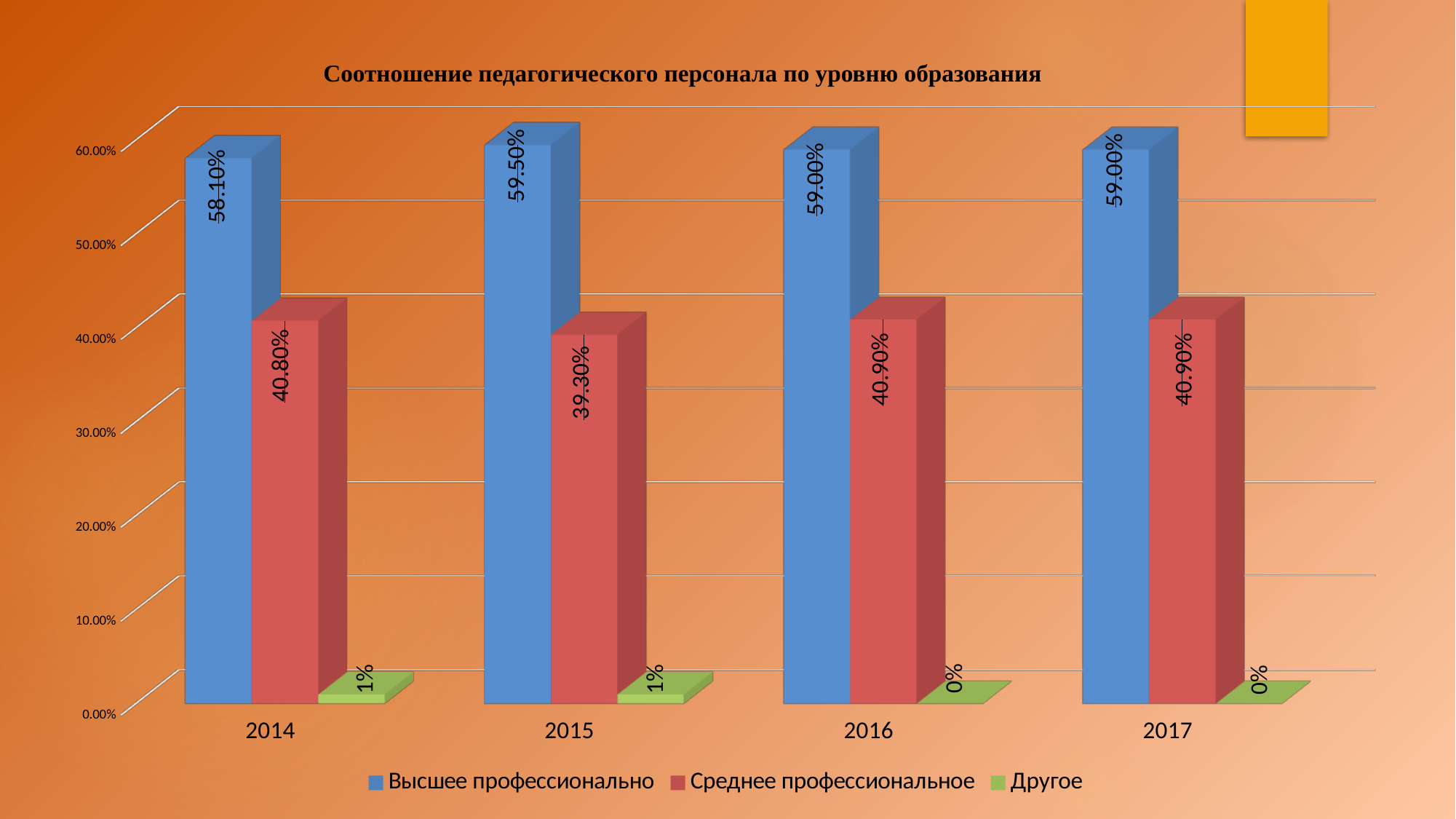
What is the value for Среднее профессиональное in 2017? 40.90% In which year is the value for Среднее профессиональное the lowest? 2015 How many years are shown on the x axis? 4 In which year is the value for Высшее профессионально the highest? 2015 What is the value for Высшее профессионально in 2014? 58.10% What is the difference between Высшее профессионально and Среднее профессиональное in 2015? 20.20% What is the value for Другое in 2016? 0% What is the value for Среднее профессиональное in 2015? 39.30% What is the title of the chart? Соотношение педагогического персонала по уровню образования What kind of chart is shown on the slide? Bar chart Which is larger in 2014: Высшее профессионально or Среднее профессиональное? Высшее профессионально How many series does the legend list? 3